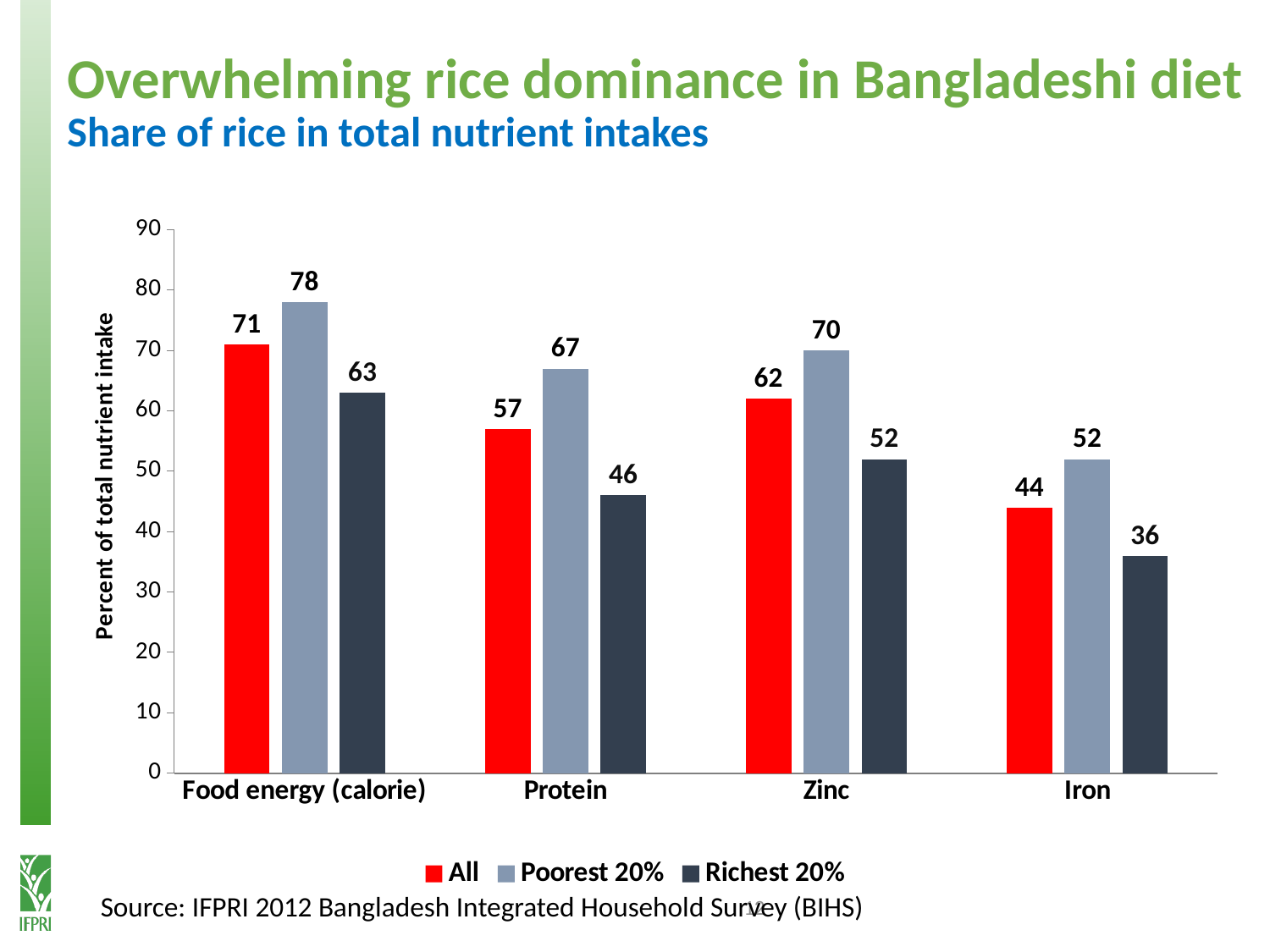
What kind of chart is shown on the slide? Bar chart What is the difference between the Poorest 20% and Richest 20% values for Protein? 21 What is the label of the y axis? Percent of total nutrient intake How many categories are shown on the x axis? 4 What is the value for Poorest 20% for Food energy (calorie)? 78 What is the value for All for Zinc? 62 Which category has the highest value for the All series? Food energy (calorie) Do the values for the All series rise or fall from Food energy (calorie) to Iron? Fall Which category has the lowest value for the Richest 20% series? Iron Which is larger: the Poorest 20% value for Zinc or the Poorest 20% value for Protein? Zinc How many series does the legend list? 3 What is the value for Richest 20% for Iron? 36